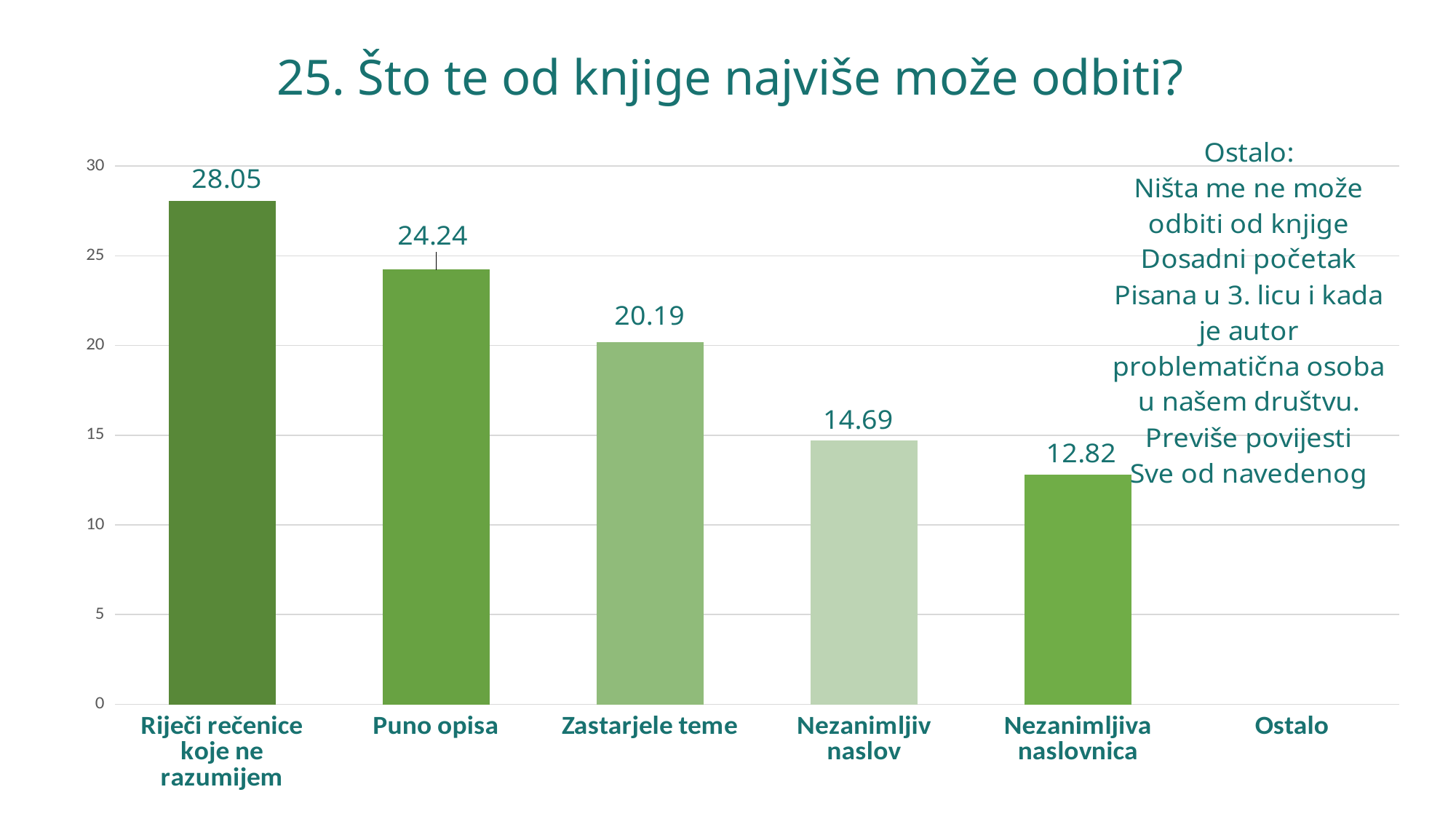
What is the value for Nezanimljiv naslov? 14.69 What is the value for Zastarjele teme? 20.19 What is the difference between the values for Riječi rečenice koje ne razumijem and Puno opisa? 3.81 What is the difference between the values for Nezanimljiv naslov and Nezanimljiva naslovnica? 1.87 Which labelled bar has the lowest value? Nezanimljiva naslovnica What kind of chart is shown on the slide? bar chart Is the value for Puno opisa greater or less than 25? less Which category has the highest value? Riječi rečenice koje ne razumijem What is the title of the chart? 25. Što te od knjige najviše može odbiti? Which is larger, the value for Zastarjele teme or the value for Nezanimljiv naslov? Zastarjele teme What is the value for Puno opisa? 24.24 How many categories are shown on the x axis? 6